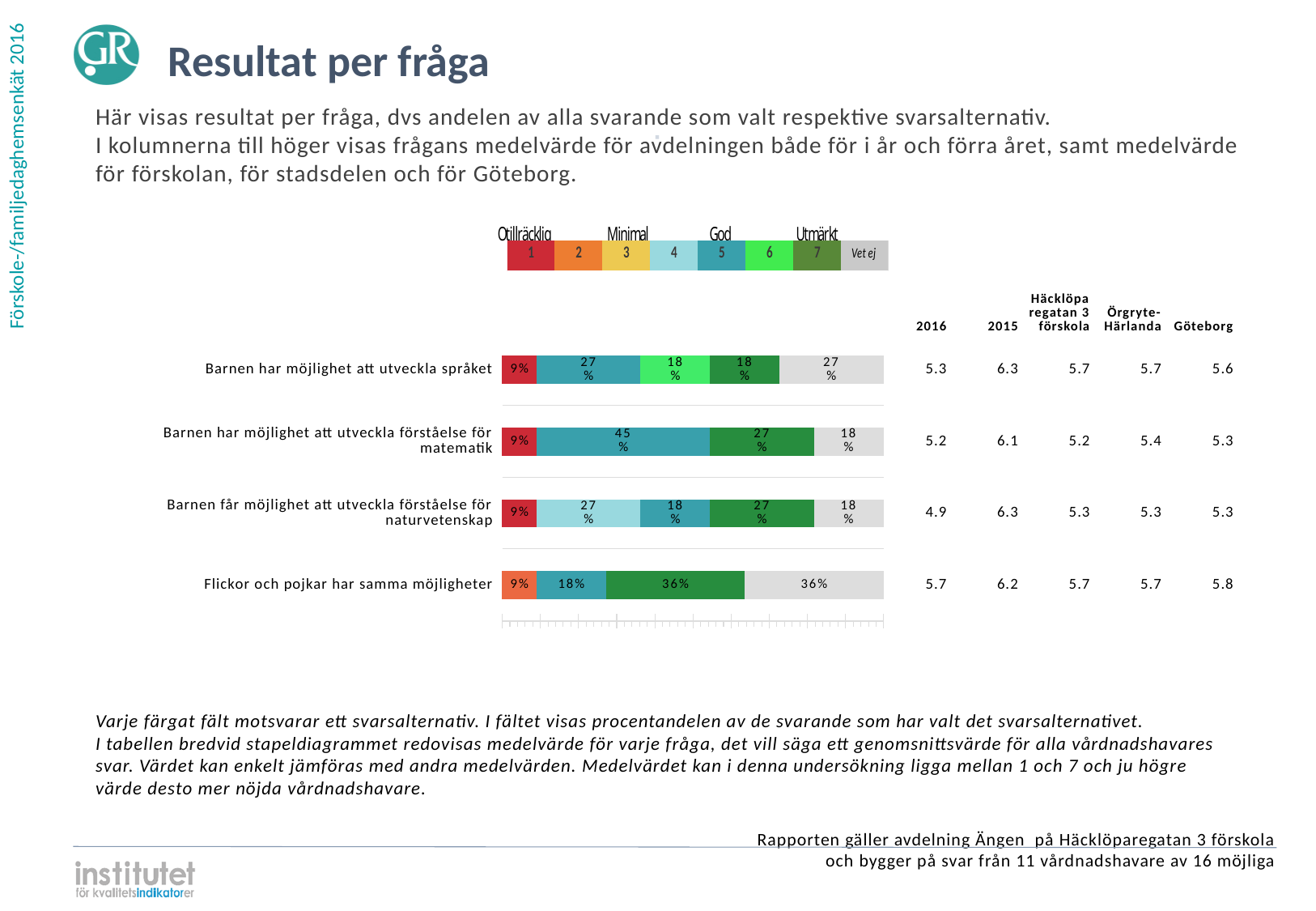
What is the largest single segment in the bar for 'Barnen har möjlighet att utveckla förståelse för matematik'? 45% What percentage of respondents answered 'Vet ej' (grey segment) for 'Flickor och pojkar har samma möjligheter'? 36% What kind of chart is shown on the slide? Stacked bar chart What is the 2016 mean value for 'Barnen får möjlighet att utveckla förståelse för naturvetenskap'? 4.9 Which question has the lowest 2016 mean value? Barnen får möjlighet att utveckla förståelse för naturvetenskap How many answer alternatives does the legend above the chart list, including 'Vet ej'? 8 What percentage of respondents answered 'Vet ej' (grey segment) for 'Barnen har möjlighet att utveckla språket'? 27% How many questions (bars) are plotted in the chart? 4 What is the 2015 mean value for 'Barnen har möjlighet att utveckla språket'? 6.3 What is the difference between the 2015 and 2016 mean values for 'Barnen får möjlighet att utveckla förståelse för naturvetenskap'? 1.4 Which question has the highest 2016 mean value? Flickor och pojkar har samma möjligheter Is the Göteborg mean value for 'Flickor och pojkar har samma möjligheter' larger or smaller than the 2016 mean value for the same question? Larger